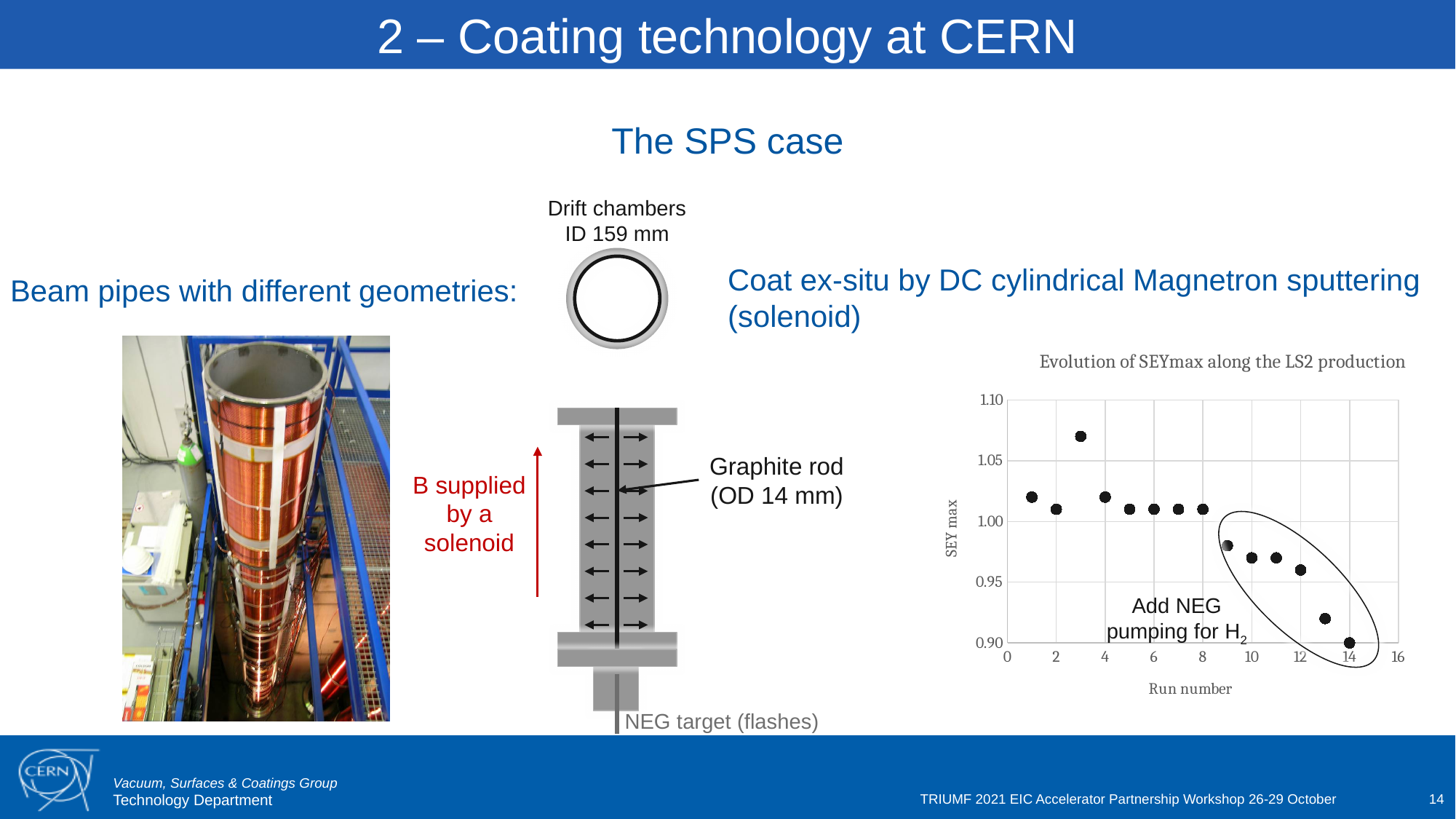
Is the SEY max for run number 1 greater or less than 1.00? greater Which run number has the highest SEY max? 3 How many data points are plotted in the chart? 14 What is the label of the x axis of the chart? Run number Is the SEY max for run number 3 greater or less than 1.05? greater Is the SEY max for run number 9 greater or less than 1.00? less Which has a higher SEY max, run number 3 or run number 12? run number 3 What kind of chart is shown on the slide? scatter plot What is the title of the chart? Evolution of SEYmax along the LS2 production Which run number has the lowest SEY max? 14 Do the SEY max values generally rise or fall from run number 9 to run number 14? fall